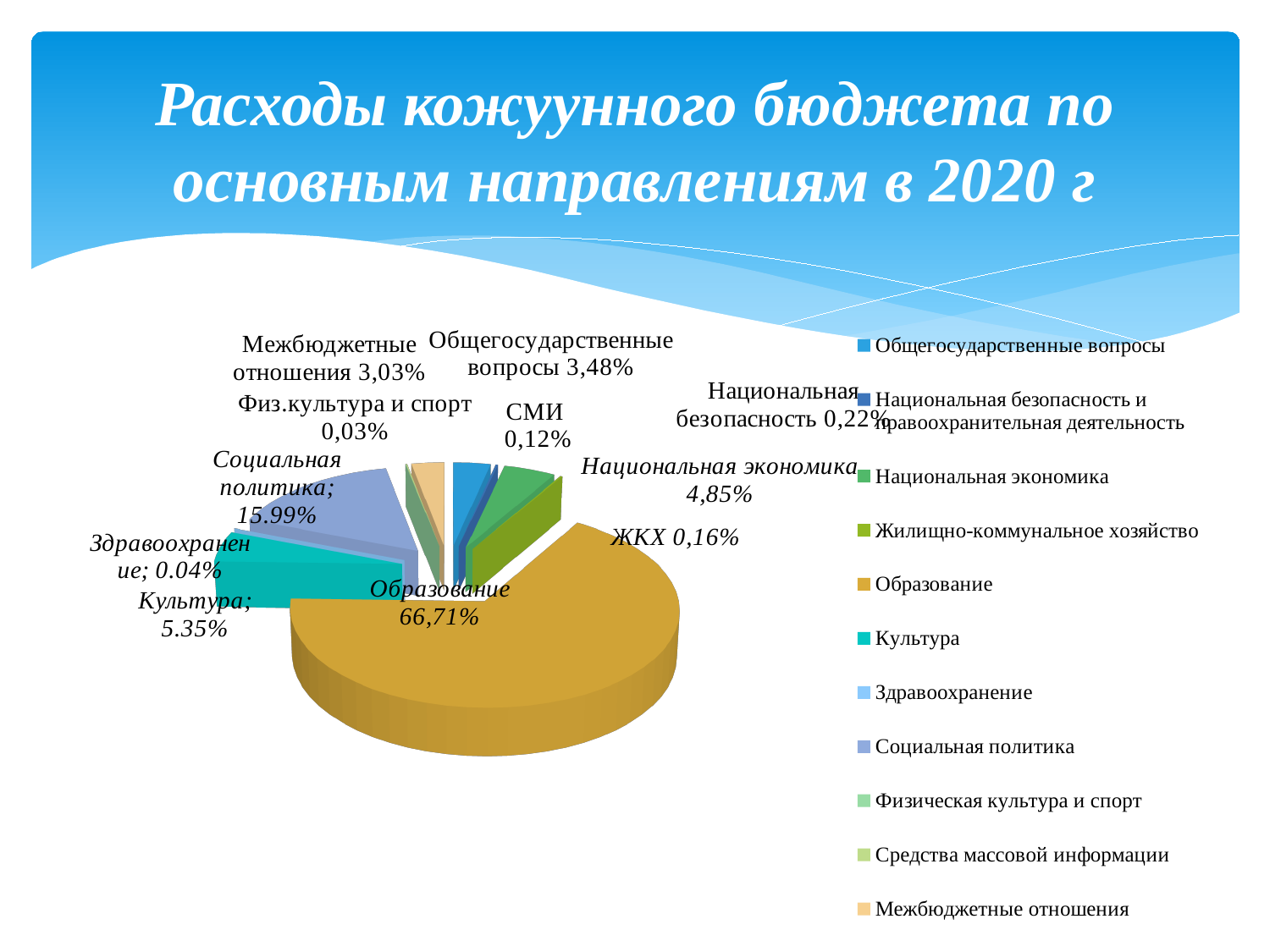
What is the value shown for Культура? 5.35% What is the value shown for Общегосударственные вопросы? 3,48% What is the value shown for Национальная экономика? 4,85% What is the value shown for Межбюджетные отношения? 3,03% What is the value shown for Социальная политика? 15.99% How many categories does the legend list? 11 What kind of chart is shown on the slide? pie chart Which is larger, the share for Культура or the share for Национальная экономика? Культура What share of the budget expenditure goes to Образование? 66,71% Which category has the largest share of the pie? Образование What is the title of the chart slide? Расходы кожуунного бюджета по основным направлениям в 2020 г Which category has the smallest share of the pie? Физ.культура и спорт